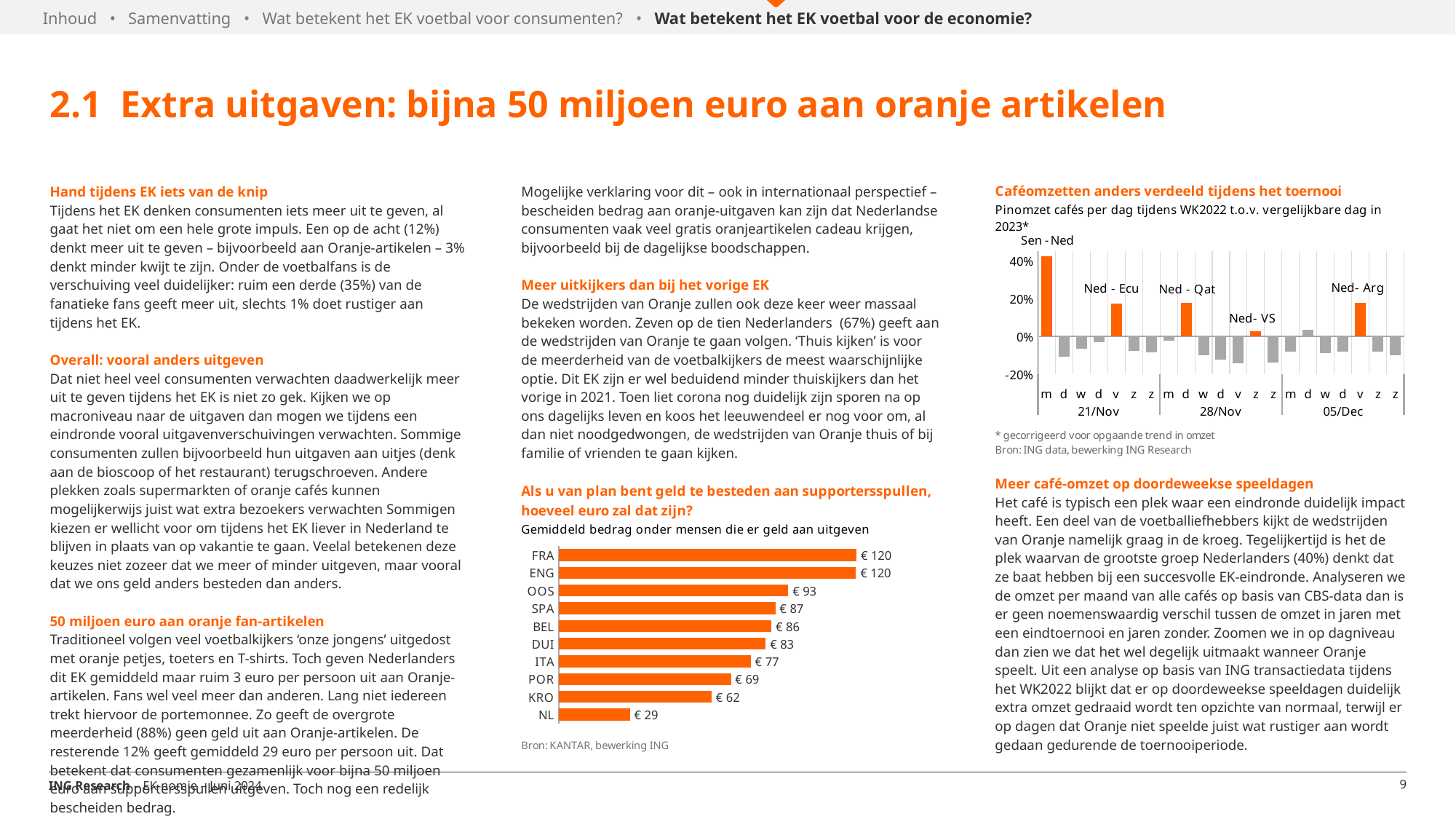
In the chart 'Als u van plan bent geld te besteden aan supportersspullen, hoeveel euro zal dat zijn?', what is the value for OOS? € 93 In the chart 'Als u van plan bent geld te besteden aan supportersspullen, hoeveel euro zal dat zijn?', which is larger, the value for POR or the value for KRO? POR In the chart 'Als u van plan bent geld te besteden aan supportersspullen, hoeveel euro zal dat zijn?', what is the value for ITA? € 77 In the chart 'Als u van plan bent geld te besteden aan supportersspullen, hoeveel euro zal dat zijn?', what is the value for NL? € 29 What is the source given below the chart 'Als u van plan bent geld te besteden aan supportersspullen, hoeveel euro zal dat zijn?'? Bron: KANTAR, bewerking ING In the chart 'Als u van plan bent geld te besteden aan supportersspullen, hoeveel euro zal dat zijn?', how many countries are shown? 10 In the chart 'Als u van plan bent geld te besteden aan supportersspullen, hoeveel euro zal dat zijn?', what is the difference between the values for FRA and NL? € 91 In the chart 'Caféomzetten anders verdeeld tijdens het toernooi', which labelled match day has the highest value? Sen-Ned In the chart 'Caféomzetten anders verdeeld tijdens het toernooi', is the value for Sen-Ned greater or less than 20%? greater In the chart 'Als u van plan bent geld te besteden aan supportersspullen, hoeveel euro zal dat zijn?', what is the difference between the values for SPA and BEL? € 1 In the chart 'Als u van plan bent geld te besteden aan supportersspullen, hoeveel euro zal dat zijn?', which country has the lowest value? NL What kind of chart is 'Als u van plan bent geld te besteden aan supportersspullen, hoeveel euro zal dat zijn?'? Bar chart